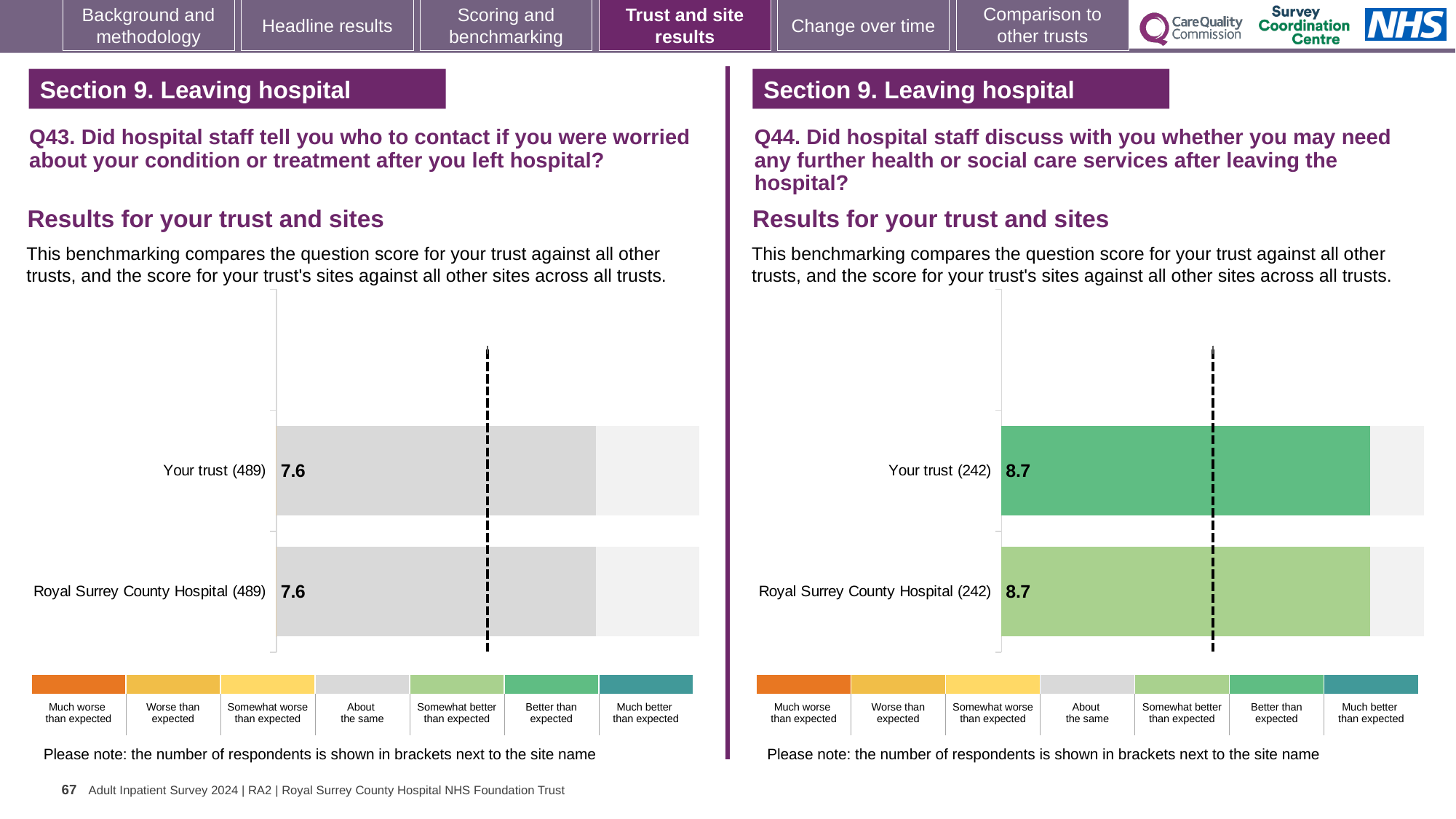
In the Q43 chart on the left, what is the score for Your trust? 7.6 In the Q43 chart on the left, how many respondents are shown in brackets for Your trust? 489 In the Q43 chart on the left, what is the score for Royal Surrey County Hospital? 7.6 In the Q44 chart on the right, what is the score for Royal Surrey County Hospital? 8.7 What kind of chart is used for the Q43 results on the left? Bar chart How many bars are plotted in the Q44 chart on the right? 2 In the Q44 chart on the right, how many respondents are shown in brackets for Royal Surrey County Hospital? 242 Is the score for Your trust in the Q44 chart on the right larger or smaller than the score for Your trust in the Q43 chart on the left? Larger In the Q43 chart on the left, what is the difference between the score for Your trust and the score for Royal Surrey County Hospital? 0 In the Q44 chart on the right, what is the score for Your trust? 8.7 How many categories does the colour key below the Q43 chart on the left list? 7 What is the difference between the Your trust score in the Q44 chart on the right and the Your trust score in the Q43 chart on the left? 1.1